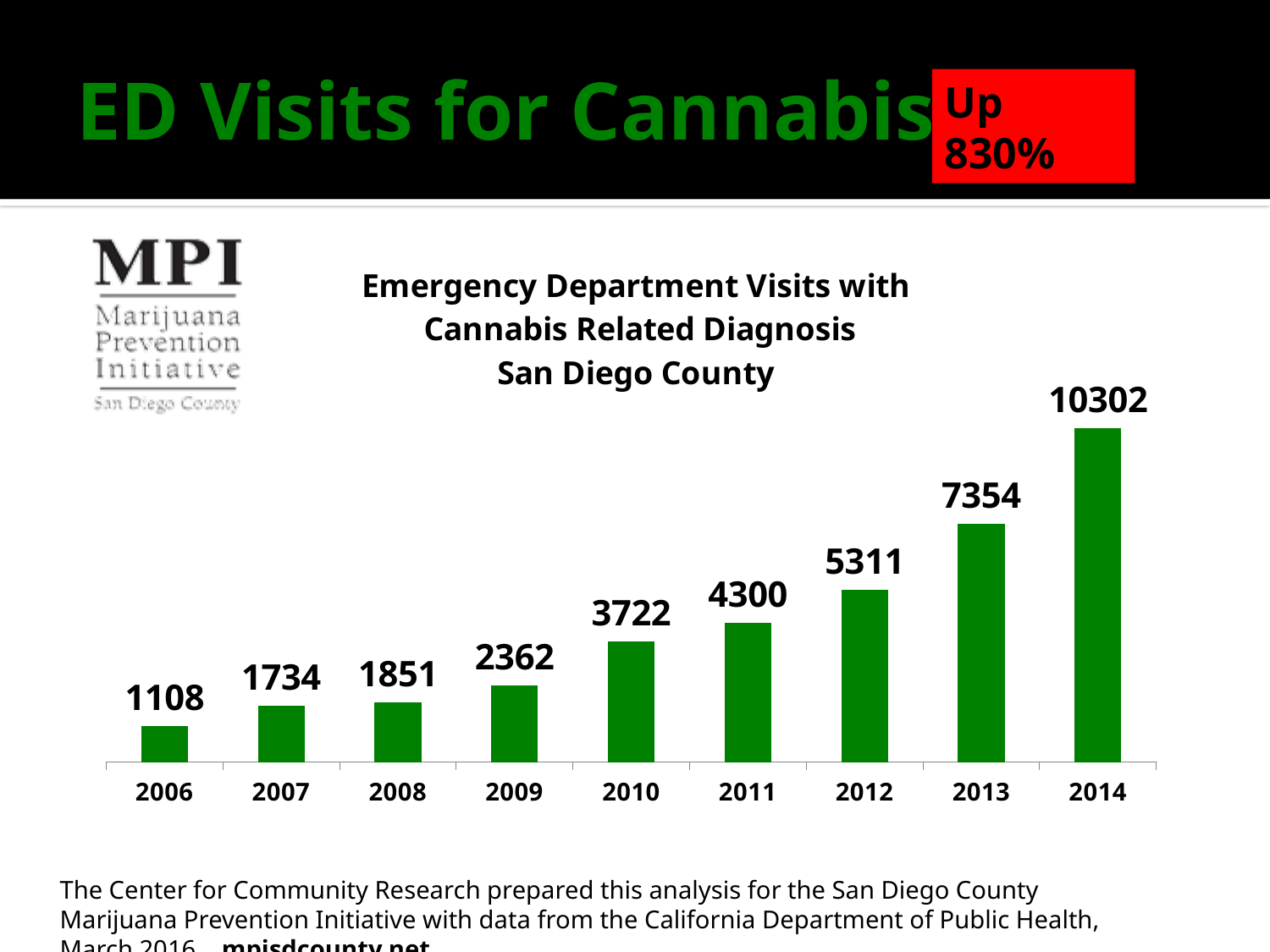
What is the value for 2010? 3722 Do the values rise or fall from 2006 to 2014? rise What is the difference between the values for 2014 and 2006? 9194 How many years are shown on the x axis? 9 Which year has the lowest value? 2006 Which is larger, the value for 2009 or the value for 2008? 2009 What kind of chart is this? bar chart What is the value for 2013? 7354 What is the value for 2006? 1108 What is the difference between the values for 2012 and 2011? 1011 What is the title of the chart? Emergency Department Visits with Cannabis Related Diagnosis San Diego County Which year has the highest value? 2014